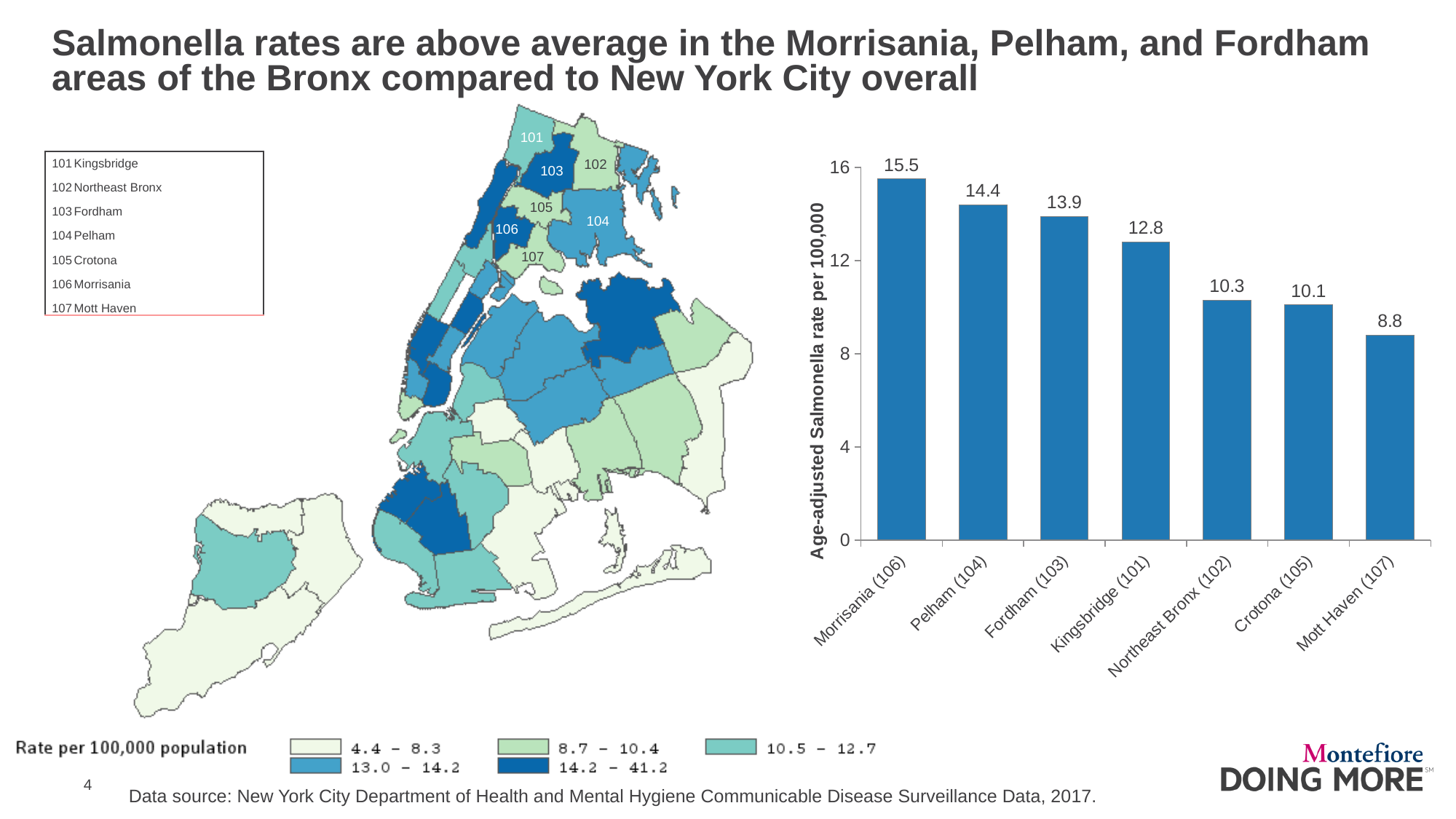
Which has a higher Salmonella rate, Northeast Bronx (102) or Crotona (105)? Northeast Bronx (102) What is the difference between the Salmonella rates for Morrisania (106) and Mott Haven (107)? 6.7 What is the label of the vertical axis of the bar chart? Age-adjusted Salmonella rate per 100,000 What is the age-adjusted Salmonella rate per 100,000 for Morrisania (106)? 15.5 What is the age-adjusted Salmonella rate per 100,000 for Kingsbridge (101)? 12.8 What is the difference between the Salmonella rates for Fordham (103) and Kingsbridge (101)? 1.1 What is the age-adjusted Salmonella rate per 100,000 for Mott Haven (107)? 8.8 How many areas are shown in the bar chart? 7 What is the age-adjusted Salmonella rate per 100,000 for Pelham (104)? 14.4 Which area has the lowest age-adjusted Salmonella rate in the bar chart? Mott Haven (107) What type of chart shows the age-adjusted Salmonella rates by area? Bar chart Which area has the highest age-adjusted Salmonella rate in the bar chart? Morrisania (106)